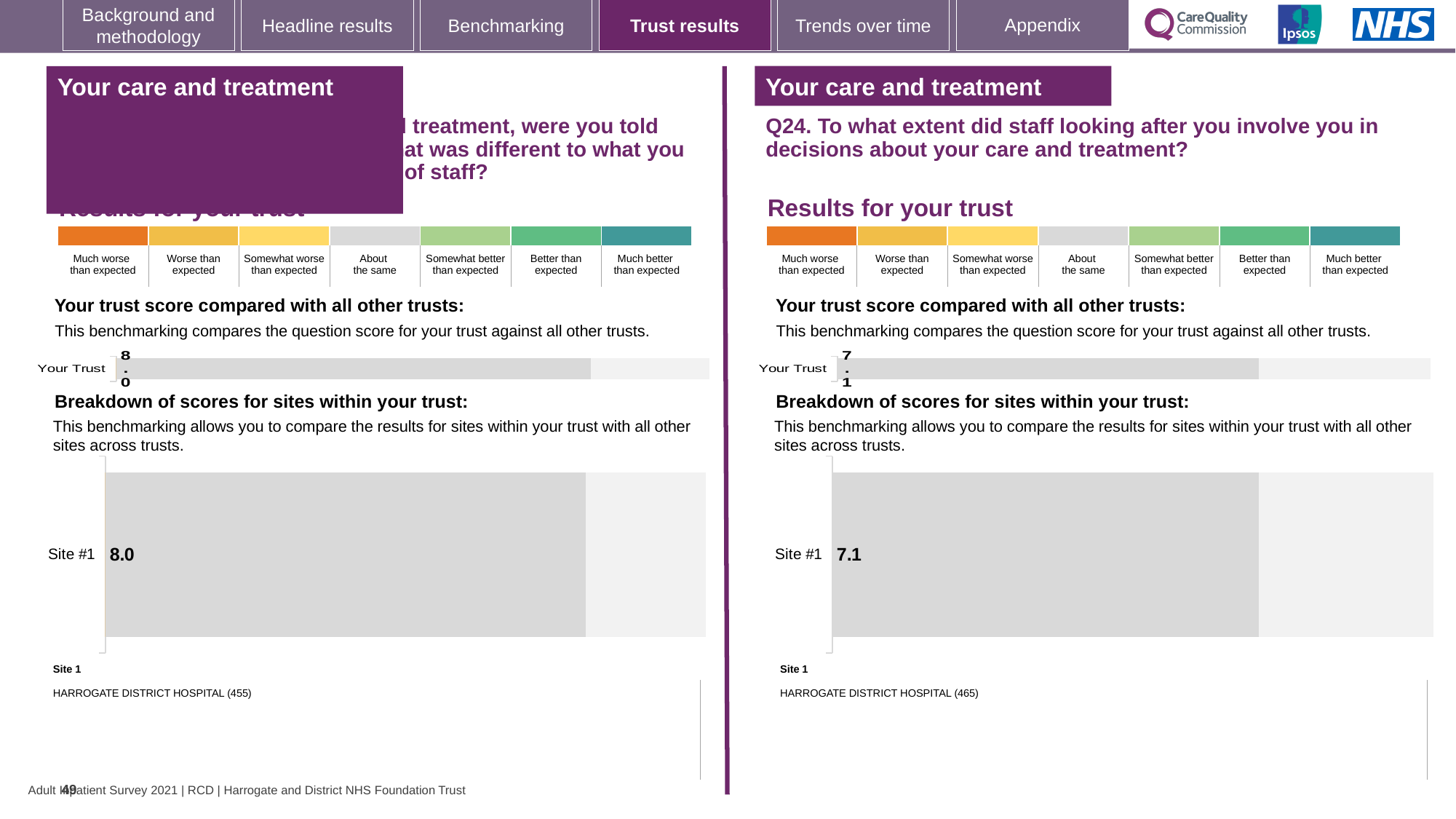
Is the Site #1 score in the left-hand breakdown chart equal to the 'Your Trust' score on the left half of the slide? Yes, both are 8.0 On the right half of the slide (Q24), what is the 'Your Trust' score shown in the trust benchmarking bar chart? 7.1 Which site is listed as Site 1 beneath the right-hand (Q24) breakdown chart? HARROGATE DISTRICT HOSPITAL (465) How many sites are plotted in the right-hand (Q24) 'Breakdown of scores for sites within your trust' chart? 1 Which site is listed as Site 1 beneath the left-hand breakdown chart? HARROGATE DISTRICT HOSPITAL (455) In the right-hand (Q24) 'Breakdown of scores for sites within your trust' chart, what is the score for Site #1? 7.1 What is the difference between the Site #1 score in the left-hand breakdown chart and the Site #1 score in the right-hand (Q24) breakdown chart? 0.9 What kind of chart is used to show the Site #1 score in the right-hand (Q24) breakdown section? Bar chart On the left half of the slide, what is the 'Your Trust' score shown in the trust benchmarking bar chart? 8.0 How many sites are plotted in the left-hand 'Breakdown of scores for sites within your trust' chart? 1 In the left-hand 'Breakdown of scores for sites within your trust' chart, what is the score for Site #1? 8.0 Which is larger: the 'Your Trust' score on the left half of the slide or the 'Your Trust' score on the right half (Q24)? Left half (8.0)